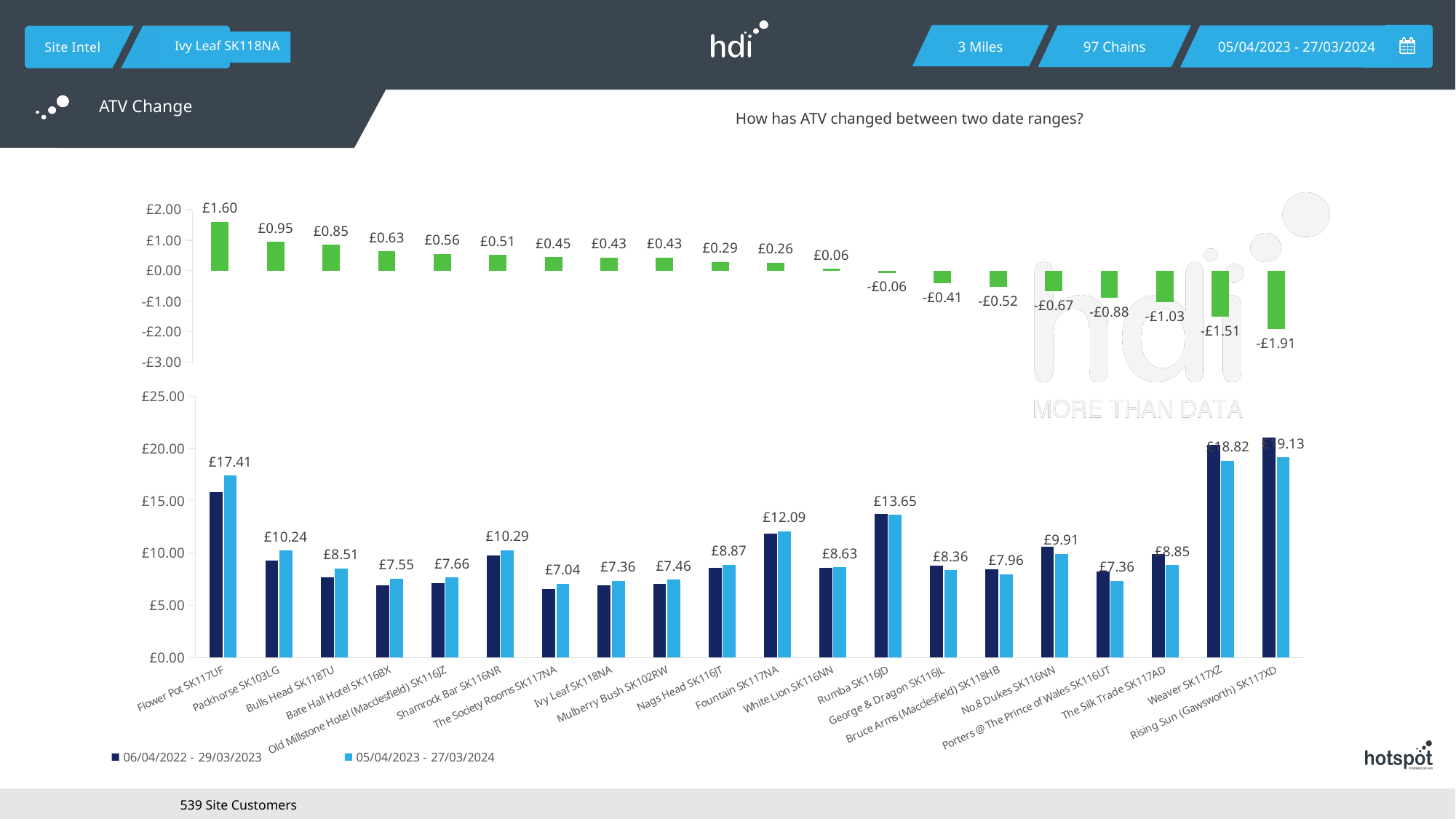
In the bottom chart, which has the larger labelled ATV: Weaver SK117XZ or Flower Pot SK117UF? Weaver SK117XZ In the top ATV change chart, what is the largest positive change shown? £1.60 In the bottom chart, what is the labelled ATV for Fountain SK117NA? £12.09 In the bottom chart, which site has the lowest labelled ATV for 05/04/2023 - 27/03/2024? The Society Rooms SK117NA In the bottom chart, what is the labelled ATV for Rumba SK116JD? £13.65 In the bottom chart, which site has the highest labelled ATV for 05/04/2023 - 27/03/2024? Rising Sun (Gawsworth) SK117XD How many sites are shown along the x axis of the bottom chart? 20 In the bottom chart, is the 06/04/2022 - 29/03/2023 value for Rumba SK116JD greater or less than £10.00? greater In the bottom chart, what is the difference between the labelled ATV of Rising Sun (Gawsworth) SK117XD and Weaver SK117XZ? £0.31 How many series does the legend of the bottom chart list? 2 In the bottom chart, what is the ATV for Rising Sun (Gawsworth) SK117XD in the 05/04/2023 - 27/03/2024 period? £19.13 In the top ATV change chart, what is the most negative change shown? -£1.91